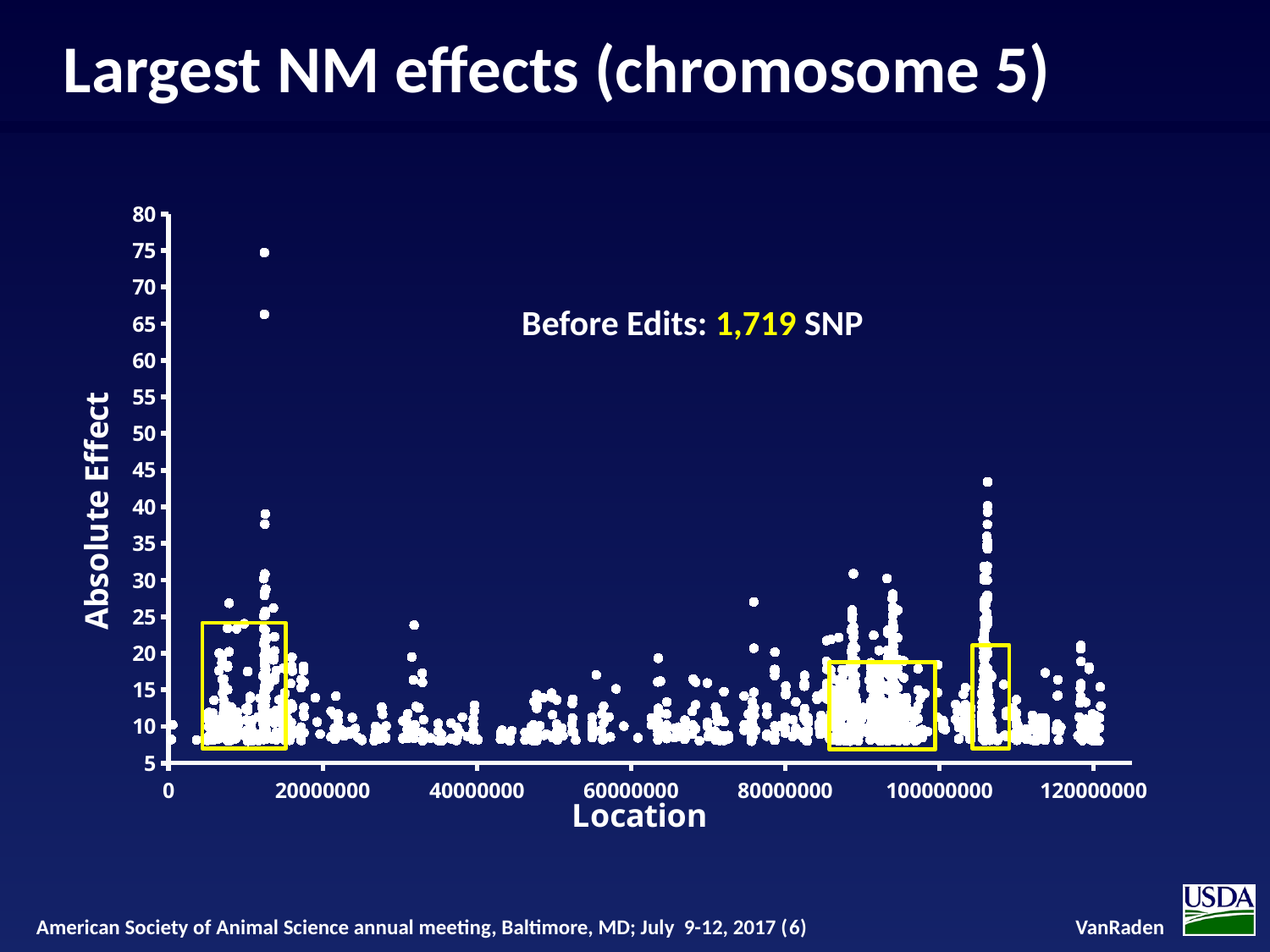
Is the highest point in the cluster near location 30000000 greater or less than 30 on the Absolute Effect axis? less Is the highest point in the cluster near location 105000000 greater or less than 40 on the Absolute Effect axis? greater What is the largest tick value shown on the Location axis? 120000000 Which region of the x axis contains the point with the largest Absolute Effect: near 20000000 or near 100000000? near 20000000 How many SNP are plotted before edits, according to the annotation on the chart? 1,719 What is the highest tick value shown on the Absolute Effect axis? 80 Is the highest point on the chart greater or less than 70 on the Absolute Effect axis? greater What is the label of the vertical axis? Absolute Effect What kind of chart is shown on the slide? scatter chart What is the title of the slide's chart? Largest NM effects (chromosome 5) What is the lowest tick value shown on the Absolute Effect axis? 5